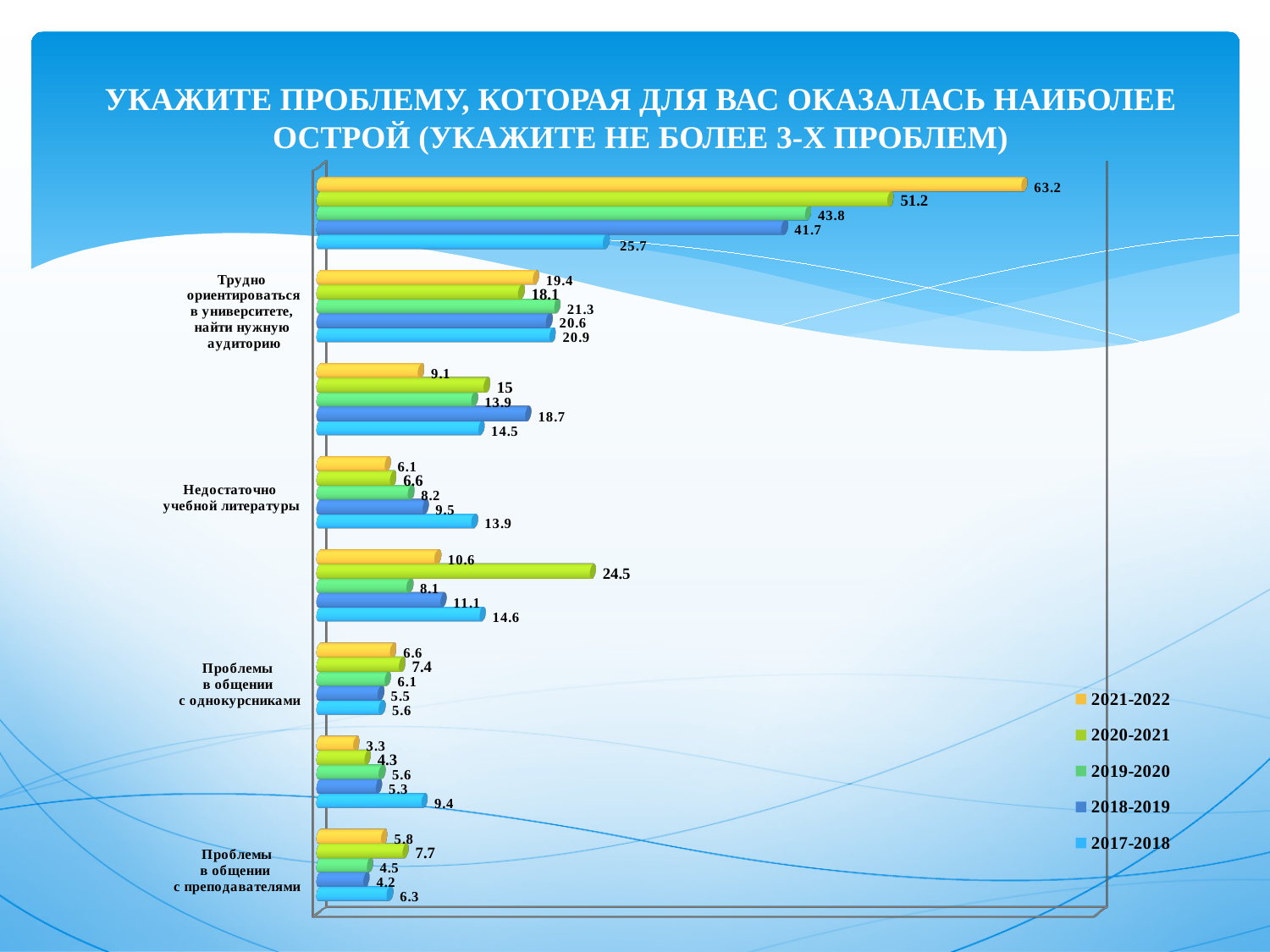
What is the value for 2020-2021 for "Проблемы в общении с однокурсниками"? 7.4 What is the value for 2017-2018 for "Недостаточно учебной литературы"? 13.9 What is the value for 2018-2019 for "Проблемы в общении с преподавателями"? 4.2 For "Проблемы в общении с преподавателями", which is larger: the 2020-2021 value or the 2017-2018 value? 2020-2021 What is the value for 2021-2022 for "Трудно ориентироваться в университете, найти нужную аудиторию"? 19.4 How many series does the legend list? 5 What kind of chart is shown on the slide? bar chart What is the difference between the 2017-2018 and 2021-2022 values for "Недостаточно учебной литературы"? 7.8 Which series has the highest value for "Трудно ориентироваться в университете, найти нужную аудиторию"? 2019-2020 Which colour represents the 2021-2022 series in the legend? yellow Which series has the highest value for "Недостаточно учебной литературы"? 2017-2018 Which series has the lowest value for "Проблемы в общении с преподавателями"? 2018-2019